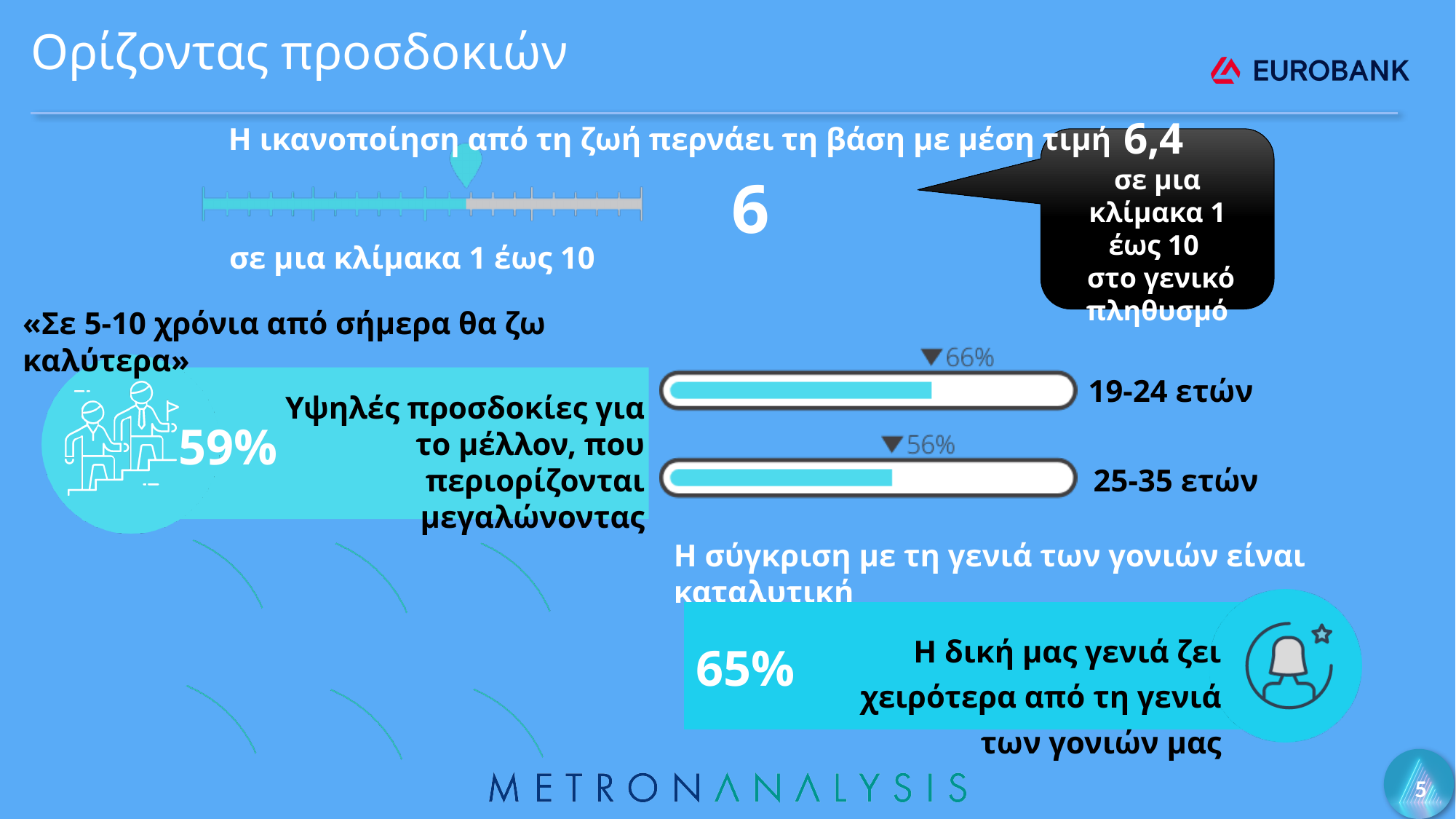
In the bar chart of age groups, which age group has the lowest value? 25-35 ετών In the bar chart of age groups, which is larger: the value for 19-24 ετών or for 25-35 ετών? 19-24 ετών In the bar chart of age groups, which age group has the highest value? 19-24 ετών How many age groups are shown in the bar chart? 2 In the bar chart of age groups, do the values rise or fall from the 19-24 group to the 25-35 group? Fall In the bar chart of age groups, what is the value for 19-24 ετών? 66% On the 1-to-10 scale at the top of the slide, what mean value for life satisfaction is shown? 6 In the bar chart of age groups, what is the value for 25-35 ετών? 56% According to the callout next to the 1-to-10 scale, what is the mean value in the general population? 6,4 In the bar chart of age groups, what is the difference between the values for 19-24 ετών and 25-35 ετών? 10 percentage points What colour are the filled portions of the bars in the age-group bar chart? Turquoise (light blue) What kind of chart shows the values for the age groups 19-24 ετών and 25-35 ετών? Bar chart